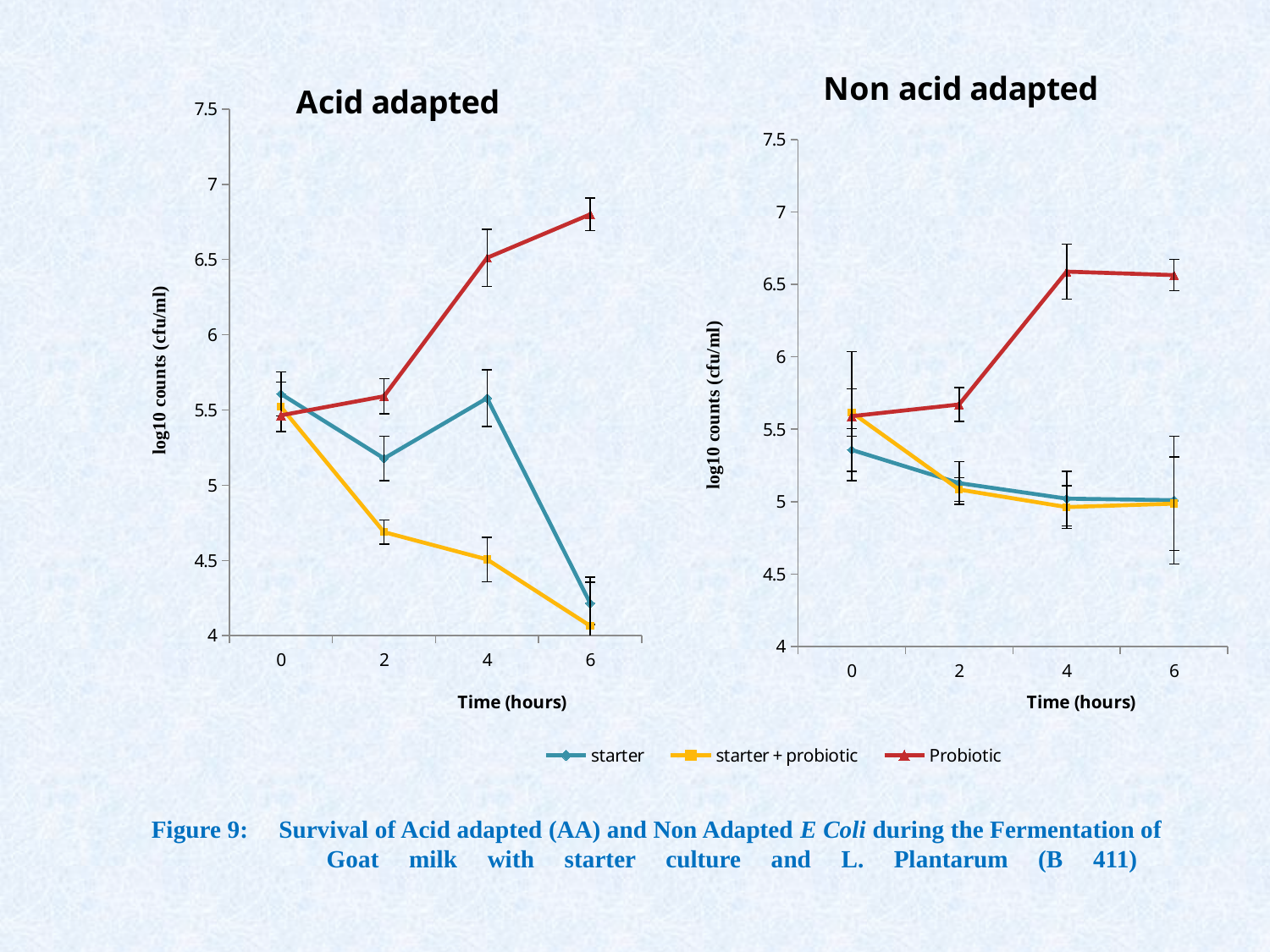
In the "Acid adapted" chart, does the Probiotic series rise or fall from 0 to 6 hours? rise In the "Acid adapted" chart, at 2 hours, which is larger: the starter value or the starter + probiotic value? starter What kind of chart is the "Acid adapted" chart? line chart What is the y-axis label on the "Acid adapted" chart? log10 counts (cfu/ml) How many series does the legend list? 3 In the "Non acid adapted" chart, is the Probiotic value at 4 hours greater or less than 6? greater In the "Acid adapted" chart, is the starter + probiotic value at 6 hours greater or less than 4.5? less In the "Non acid adapted" chart, how many time points are plotted along the x axis? 4 In the "Non acid adapted" chart, which series has the highest value at 6 hours? Probiotic In the "Acid adapted" chart, is the Probiotic value at 6 hours greater or less than 6.5? greater In the "Acid adapted" chart, does the starter + probiotic series rise or fall from 0 to 6 hours? fall In the "Non acid adapted" chart, does the starter series rise or fall from 0 to 4 hours? fall